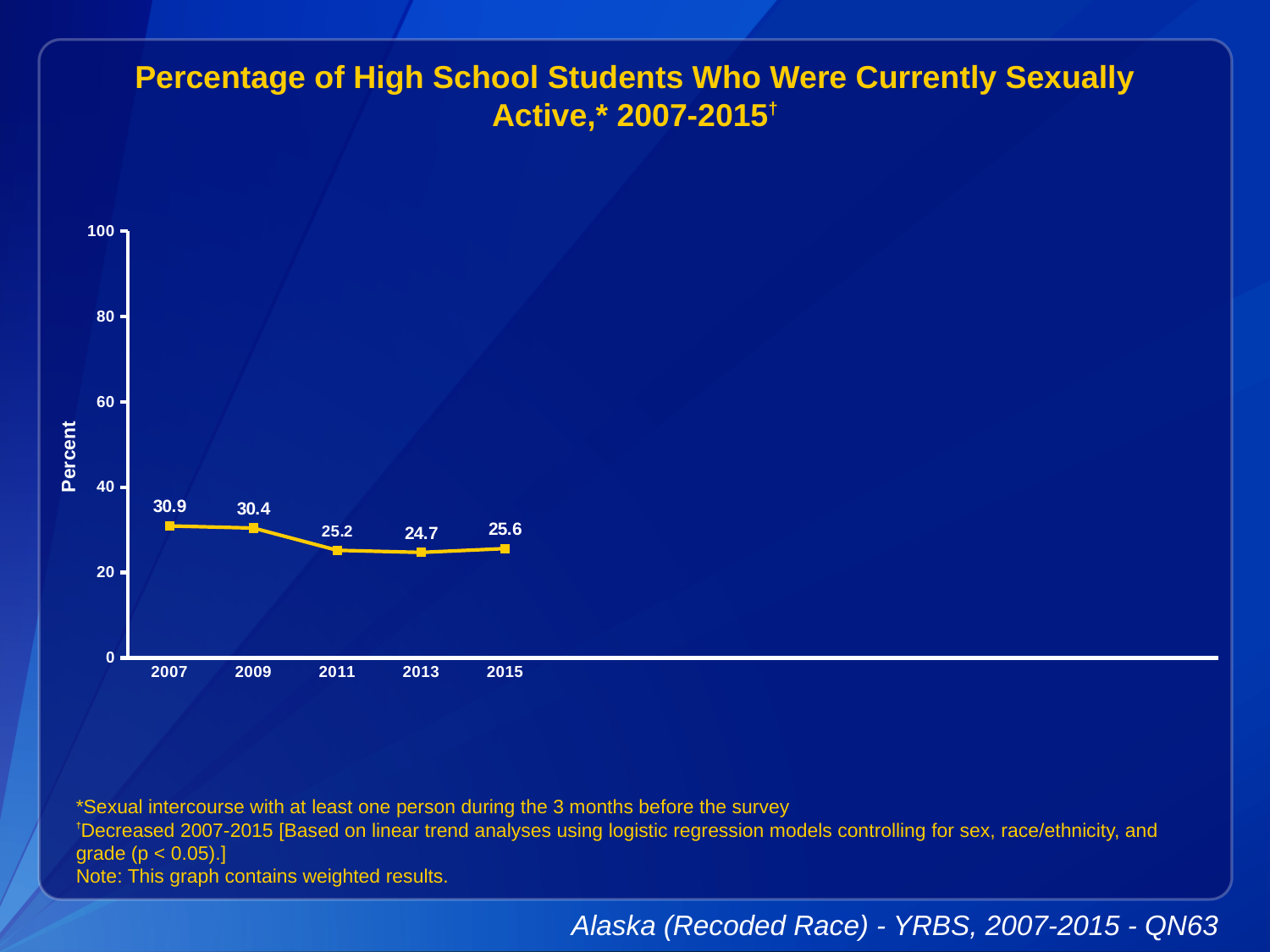
Which year has the highest percentage? 2007 What value is shown for 2015? 25.6 Is the value for 2013 greater or less than 40? less Which year has the lowest percentage? 2013 Which is larger, the value for 2009 or the value for 2011? 2009 What was the percentage of high school students who were currently sexually active in 2007? 30.9 Do the values generally rise or fall from 2007 to 2015? fall What is the difference between the 2007 value and the 2013 value? 6.2 What value is shown for 2011? 25.2 How many years are plotted on the chart? 5 What is the label on the y axis? Percent What kind of chart is shown on the slide? line chart